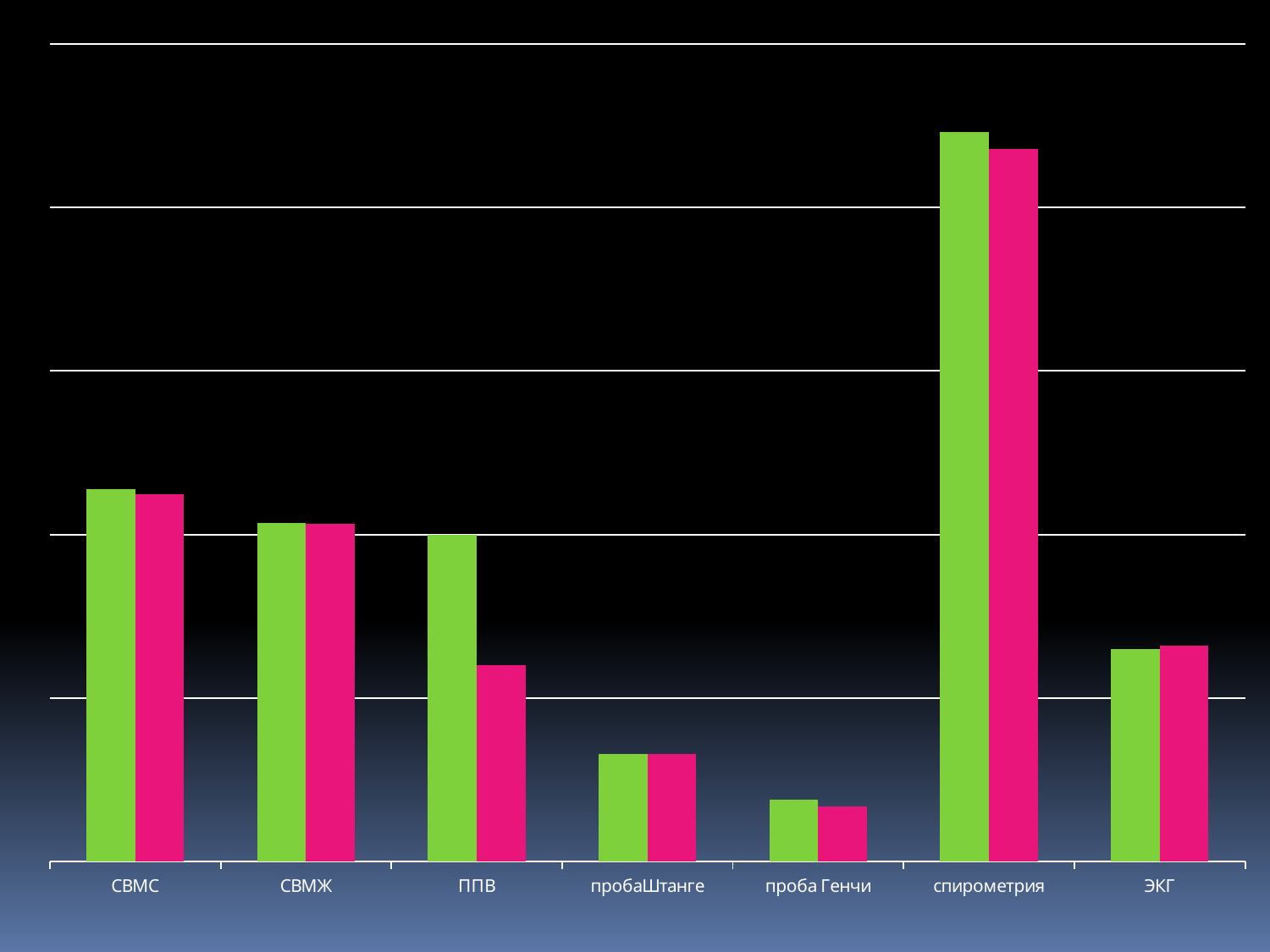
What kind of chart is shown on the slide? bar chart Does the chart display a legend? No How many bars are shown for each category? 2 Which category has the taller green bar, пробаШтанге or проба Генчи? пробаШтанге Which category has the highest bars? спирометрия How many categories are shown on the x axis? 7 Which category has the taller pink bar, СВМЖ or спирометрия? спирометрия Which category has the taller pink bar, ППВ or ЭКГ? ЭКГ What two colours are used for the bars in the chart? green and pink Which category has the lowest bars? проба Генчи